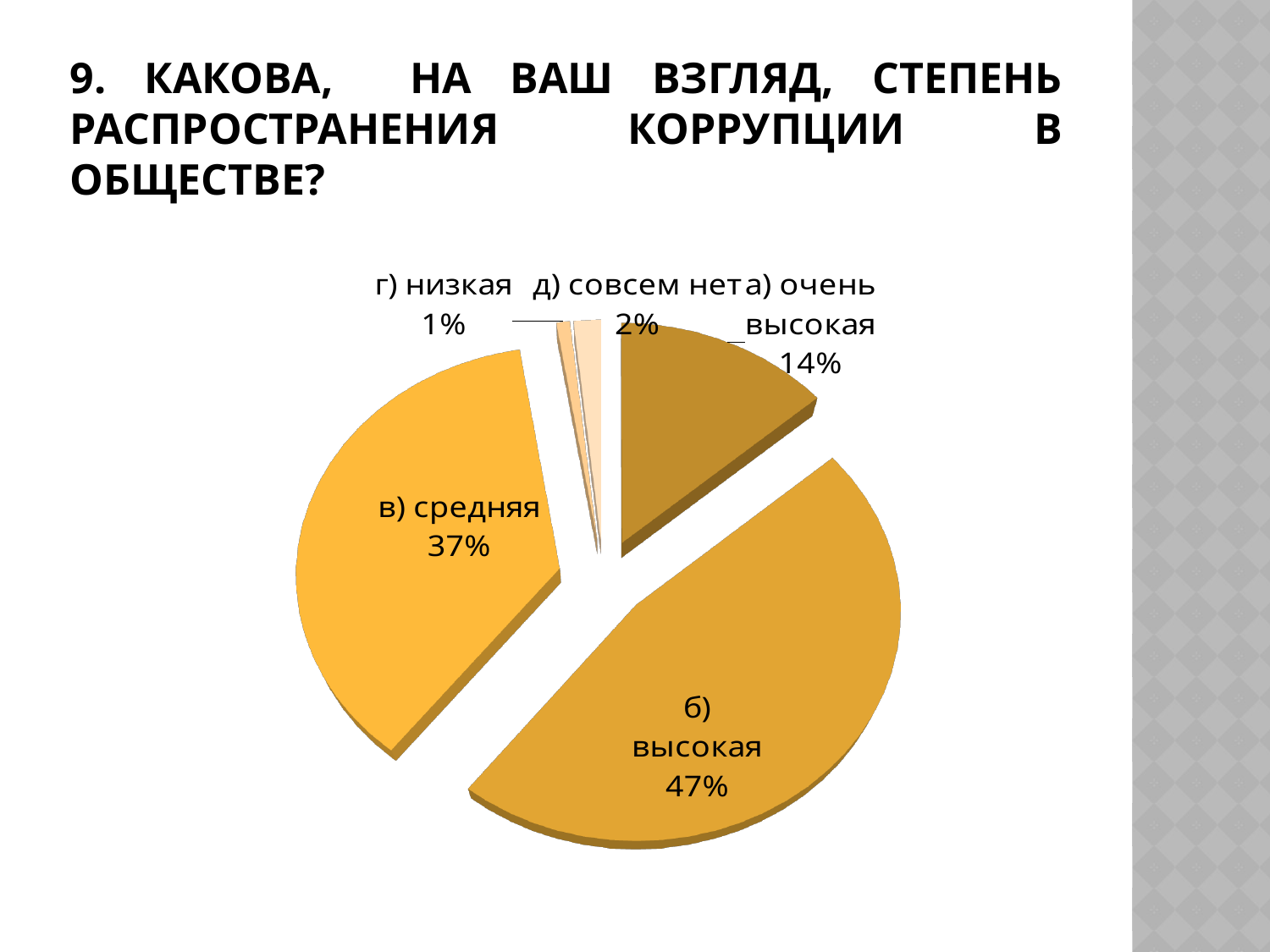
What is the value shown for "г) низкая"? 1% What is the value shown for "д) совсем нет"? 2% What is the difference between the shares of "б) высокая" and "в) средняя"? 10% Which category has the largest slice of the pie? б) высокая What kind of chart is shown on the slide? pie chart How many slices does the pie chart have? 5 Which is larger, the share for "а) очень высокая" or the share for "д) совсем нет"? а) очень высокая What is the value shown for "в) средняя"? 37% What is the value shown for "а) очень высокая"? 14% Which category has the smallest slice of the pie? г) низкая What share of the pie does "б) высокая" take? 47% What is the combined share of "а) очень высокая" and "б) высокая"? 61%